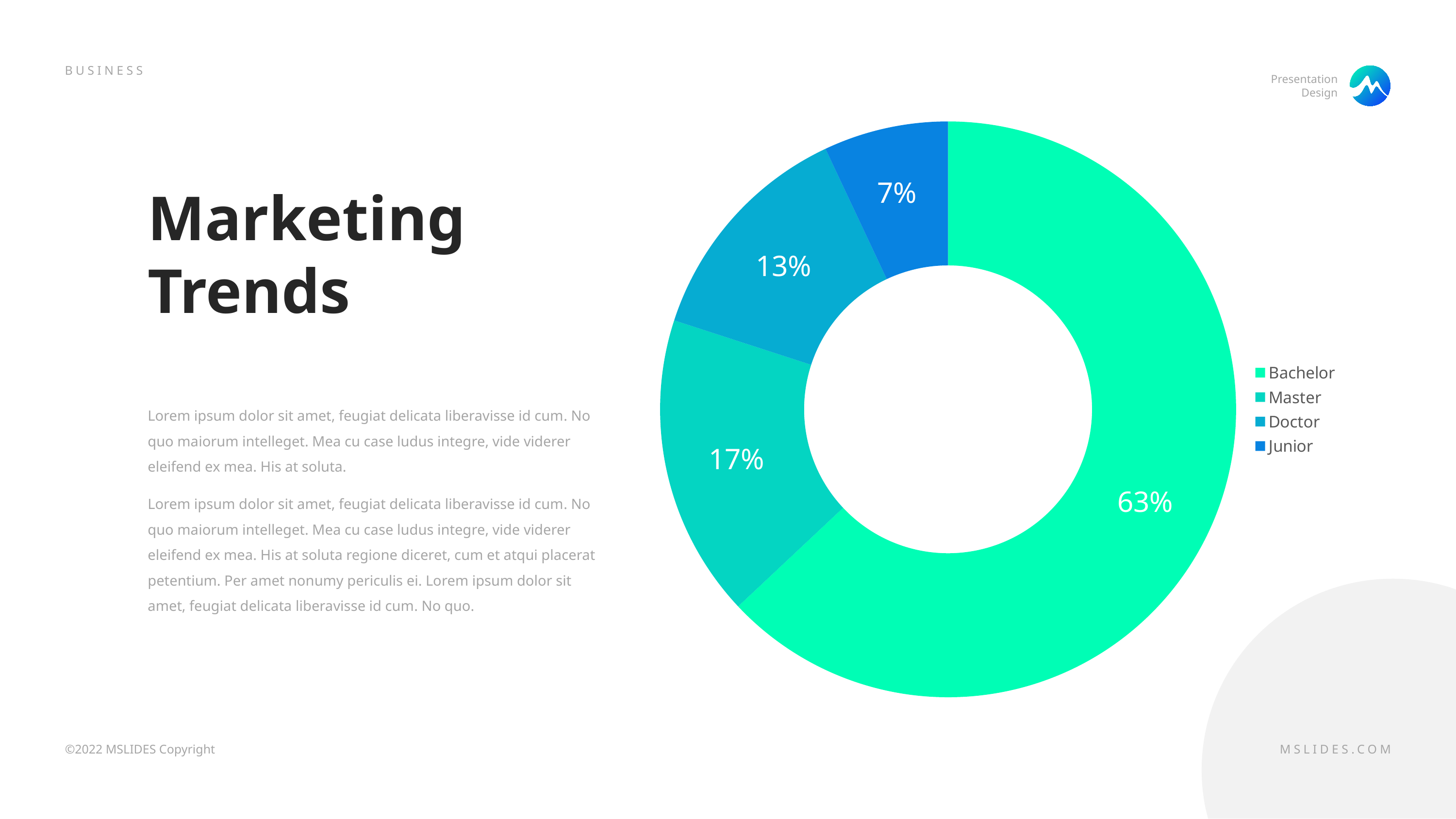
How many categories does the chart show? 4 What percentage is shown for the Doctor slice? 13% What is the difference in percentage points between the Bachelor and Master slices? 46 What is the difference in percentage points between the Doctor and Junior slices? 6 Which category has the smallest share of the chart? Junior Which slice is larger, Master or Doctor? Master What percentage is shown for the Junior slice? 7% Which category is shown in the darkest blue colour in the legend? Junior What percentage of the doughnut chart does the Bachelor slice represent? 63% Which category has the largest share of the chart? Bachelor What percentage is shown for the Master slice? 17% What type of chart is shown on the slide? Doughnut chart